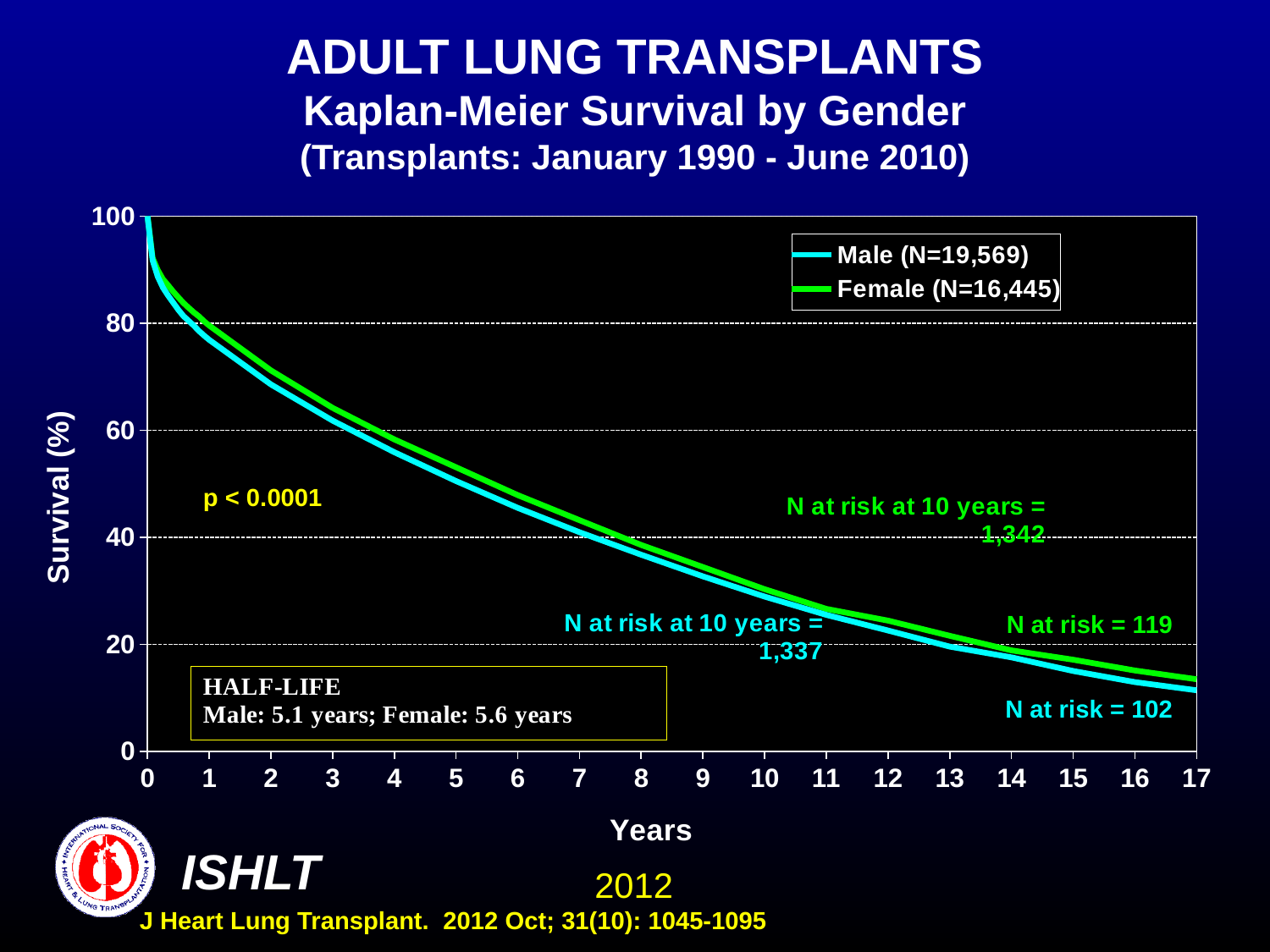
What is the number of female patients (N) shown in the legend? 16,445 What is the N at risk at 10 years for the Female group? 1,342 Do the survival curves rise or fall as years increase? fall What is the N at risk at 10 years for the Male group? 1,337 What is the half-life for male recipients? 5.1 years How many series does the legend list? 2 Is the survival for the Female group at 10 years greater or less than 40%? less What is the half-life for female recipients? 5.6 years What kind of chart is shown on the slide? line chart What p-value is shown on the chart? p < 0.0001 Which group has the longer half-life, Male or Female? Female What is the number of male patients (N) shown in the legend? 19,569